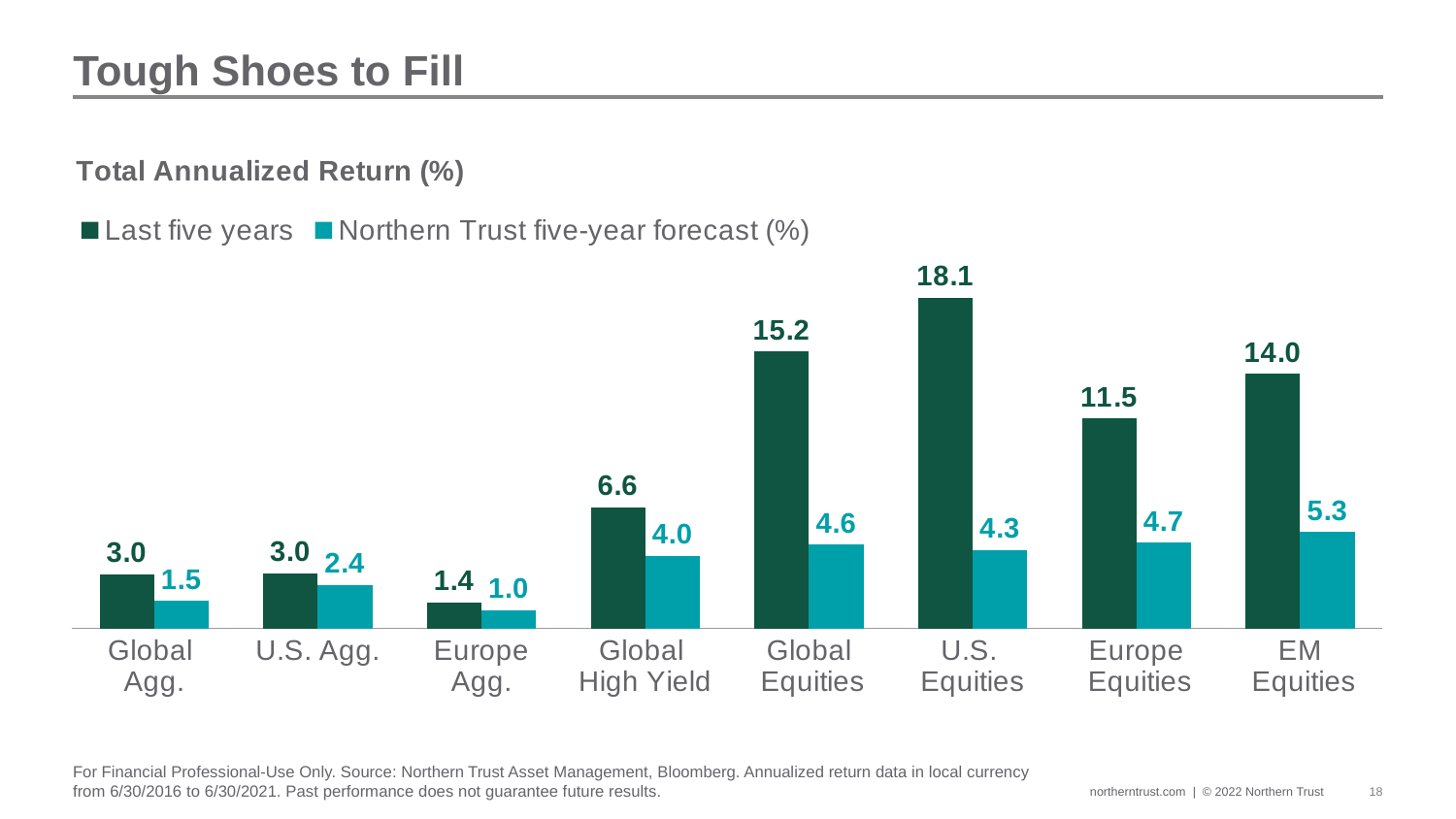
How many series does the legend list? 2 What is the 'Northern Trust five-year forecast (%)' value for EM Equities? 5.3 Which is larger: the 'Northern Trust five-year forecast (%)' for Global High Yield or for Europe Equities? Europe Equities What kind of chart is shown on the slide? Bar chart What is the 'Last five years' value for Europe Agg.? 1.4 What is the 'Last five years' value for U.S. Equities? 18.1 What is the difference between the 'Last five years' and 'Northern Trust five-year forecast (%)' values for Global Equities? 10.6 Which category has the lowest 'Northern Trust five-year forecast (%)' value? Europe Agg. What is the title of the chart? Total Annualized Return (%) What is the difference between the 'Last five years' values for U.S. Equities and Europe Equities? 6.6 Which category has the highest 'Last five years' value? U.S. Equities How many categories are shown on the x axis? 8